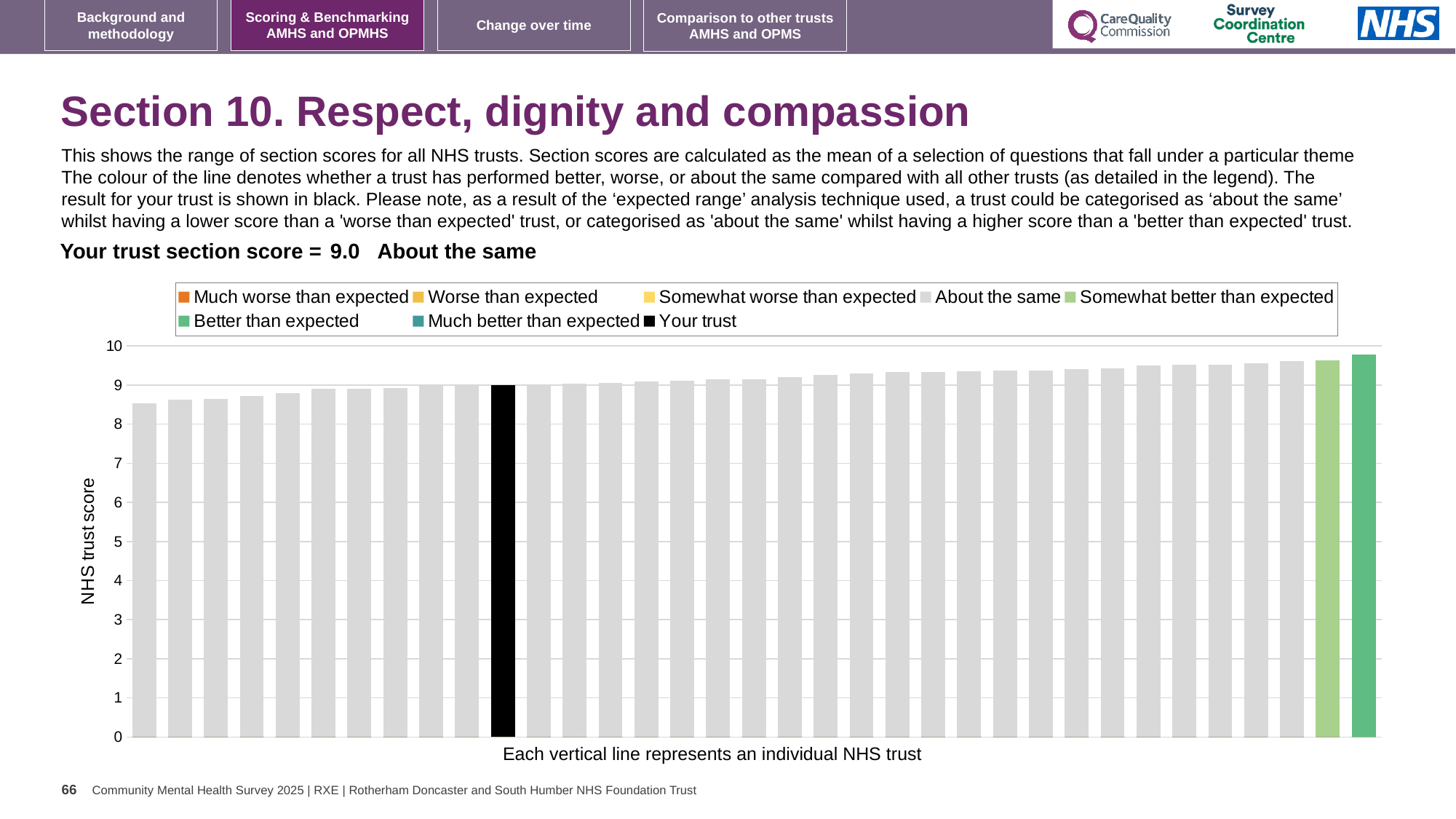
What kind of chart is shown on the slide? bar chart How many entries does the chart legend list? 8 Which category is your trust placed in according to the text above the chart? About the same Which is taller: the black bar for your trust or the leftmost bar? the black bar for your trust Is the value of the black bar (your trust) greater or less than 8? greater What is the highest value shown on the vertical axis? 10 What is the section score for your trust shown on the slide? 9.0 Is the value of the leftmost bar greater or less than 9? less Do the bar values rise or fall from left to right along the x axis? rise Is the value of the rightmost bar greater or less than 9? greater What is the label on the vertical axis of the chart? NHS trust score